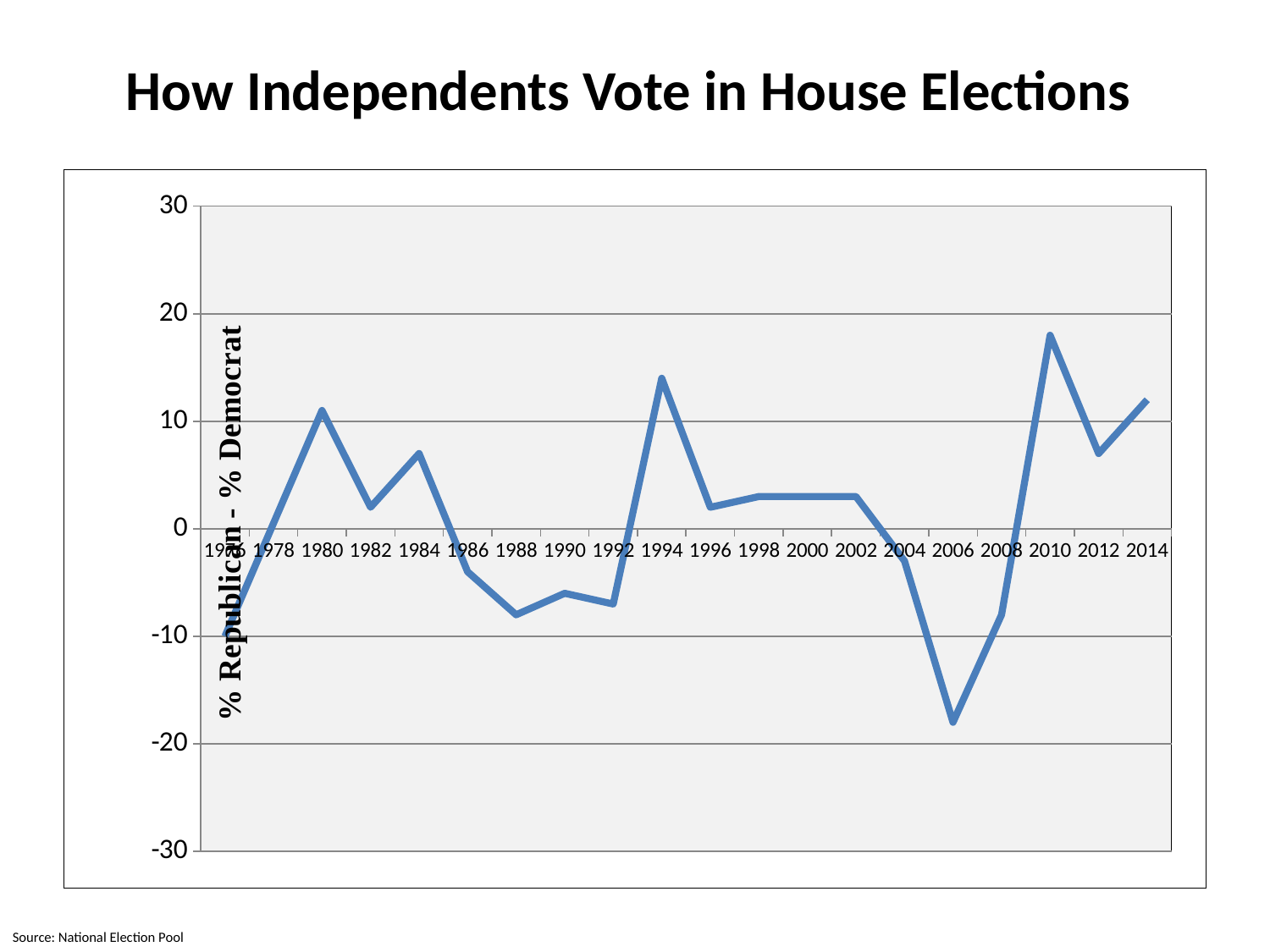
What is the label on the vertical axis? % Republican - % Democrat Which year has the larger value, 1980 or 1982? 1980 What kind of chart is shown on the slide? Line chart Is the value for 2010 greater or less than 10? greater How many election years are plotted on the x axis? 20 Is the value for 2006 greater or less than -10? less In which year does the line reach its lowest value? 2006 Is the value for 1984 greater or less than 0? greater In which year does the line reach its highest value? 2010 Which year has the larger value, 2010 or 1994? 2010 Does the line rise or fall between 2006 and 2010? Rises